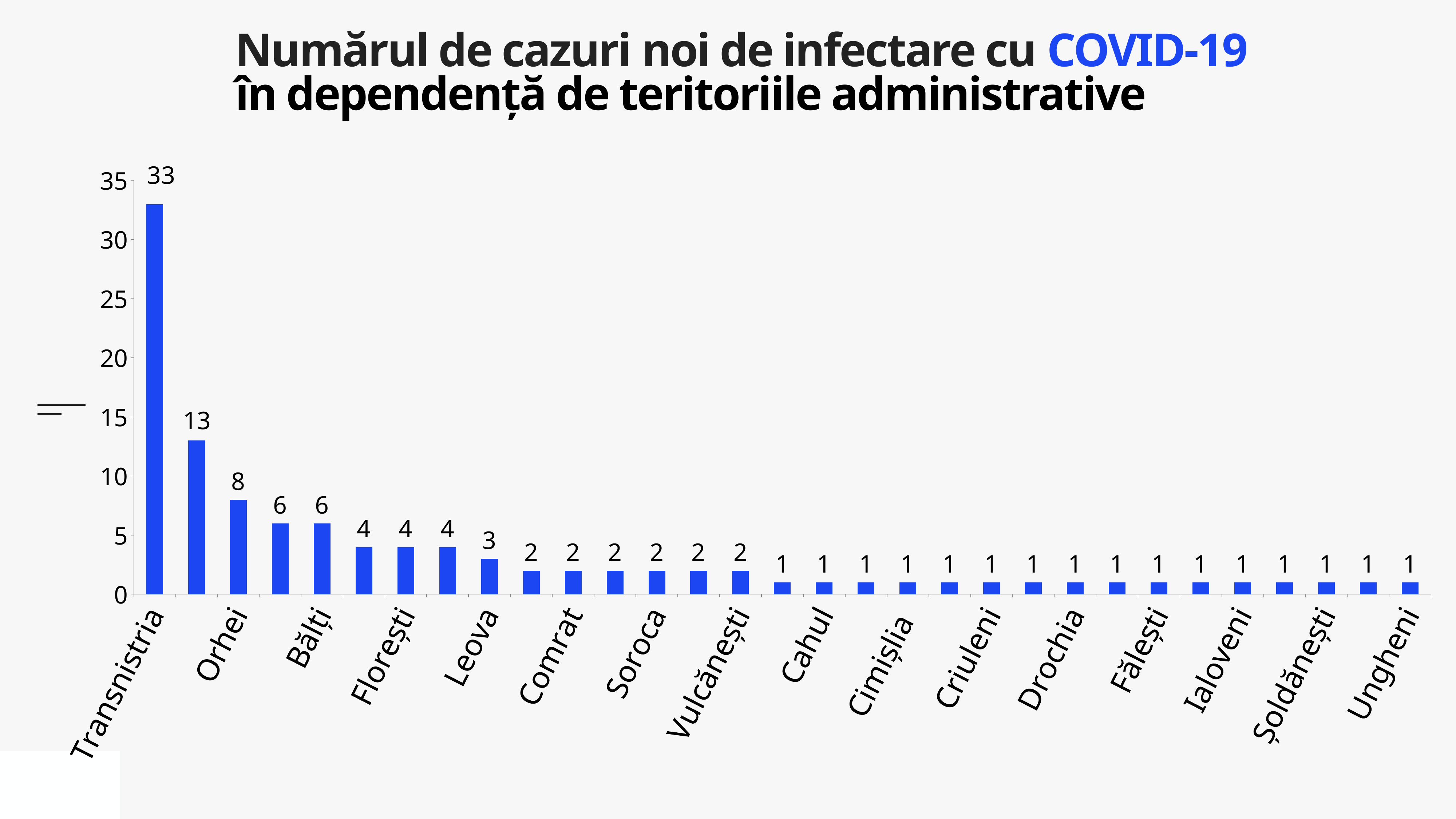
What is the value for Comrat? 2 What is the value for Ungheni? 1 Which category has the highest value? Transnistria What is the value for Bălți? 6 Is the value for Transnistria greater or less than 30? greater What colour are the bars in the chart? blue Do the values rise or fall from left to right along the x axis? fall What is the value for Florești? 4 What type of chart is shown on the slide? bar chart Which is larger, the value for Transnistria or the value for Soroca? Transnistria What is the difference between the values for Transnistria and Bălți? 27 What is the value for Transnistria? 33